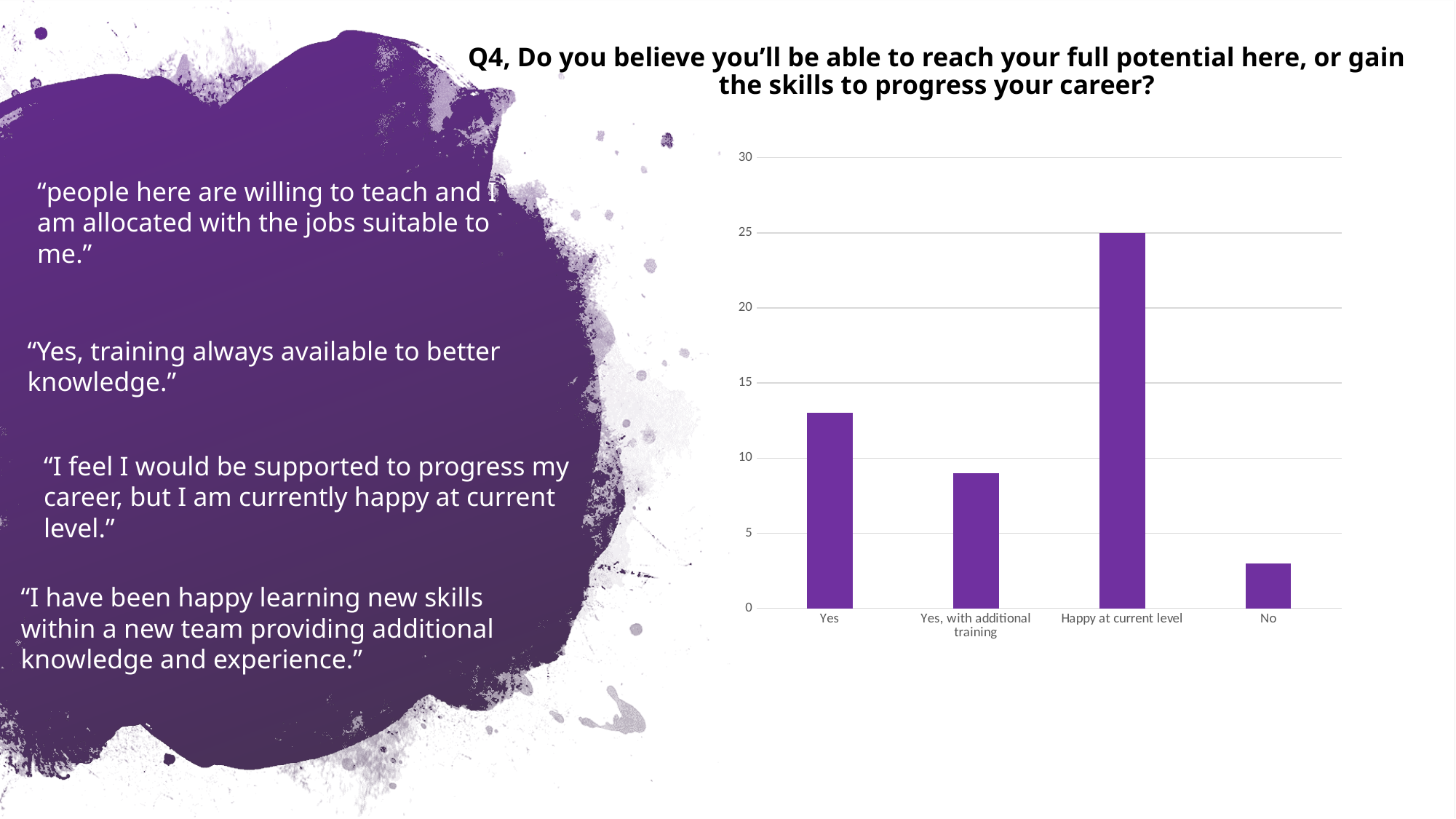
What colour are the bars in the chart? purple What is the value for "Happy at current level"? 25 Is the value for "Yes" greater or less than 15? less Which is larger, the value for "Yes" or the value for "Yes, with additional training"? Yes Is the value for "No" greater or less than 5? less What type of chart is shown on the slide? bar chart How many categories are shown on the x axis of the chart? 4 Is the value for "Yes, with additional training" greater or less than 15? less Which category has the lowest value in the chart? No What is the title of the chart? Q4, Do you believe you'll be able to reach your full potential here, or gain the skills to progress your career? Which category has the highest value in the chart? Happy at current level